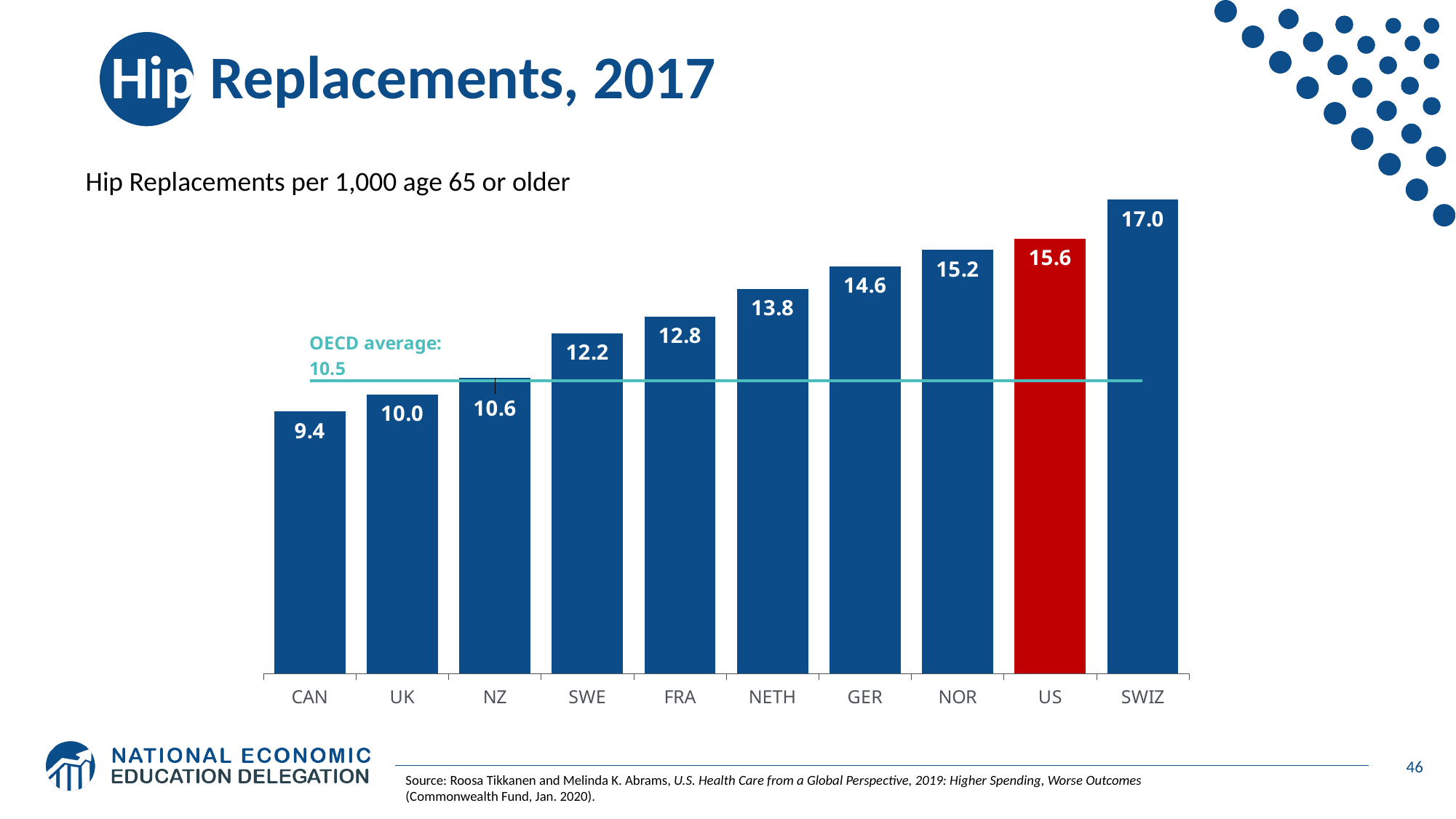
Which has a higher value, FRA or NETH? NETH What is the value for Germany (GER) in the hip replacements chart? 14.6 Which country has the lowest number of hip replacements per 1,000 age 65 or older? CAN What is the value for the US in the hip replacements chart? 15.6 How many countries are shown in the chart? 10 What OECD average value is marked by the horizontal line on the chart? 10.5 What kind of chart is shown on the slide? Bar chart What is the difference between the values for NOR and the UK? 5.2 Which country has the highest number of hip replacements per 1,000 age 65 or older? SWIZ What is the difference between the values for SWIZ and the US? 1.4 Do the values rise or fall moving from left to right across the chart? Rise What is the value for Canada (CAN) in the hip replacements chart? 9.4